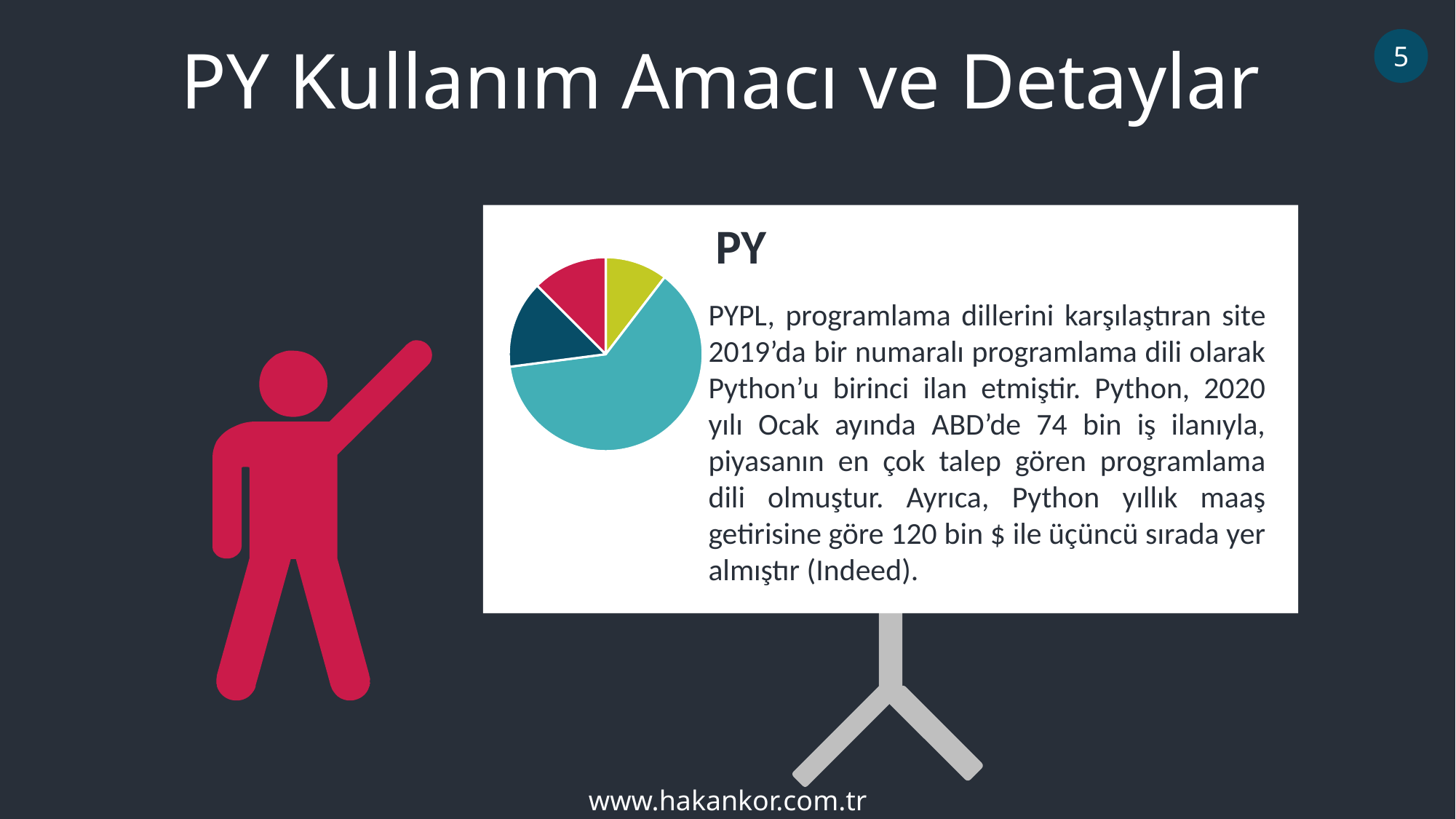
Is the teal slice of the pie chart larger or smaller than half of the pie? larger How many slices does the pie chart have? 4 Does the pie chart have a legend? No Which colour slice is the largest in the pie chart? teal What kind of chart is shown on the slide? pie chart